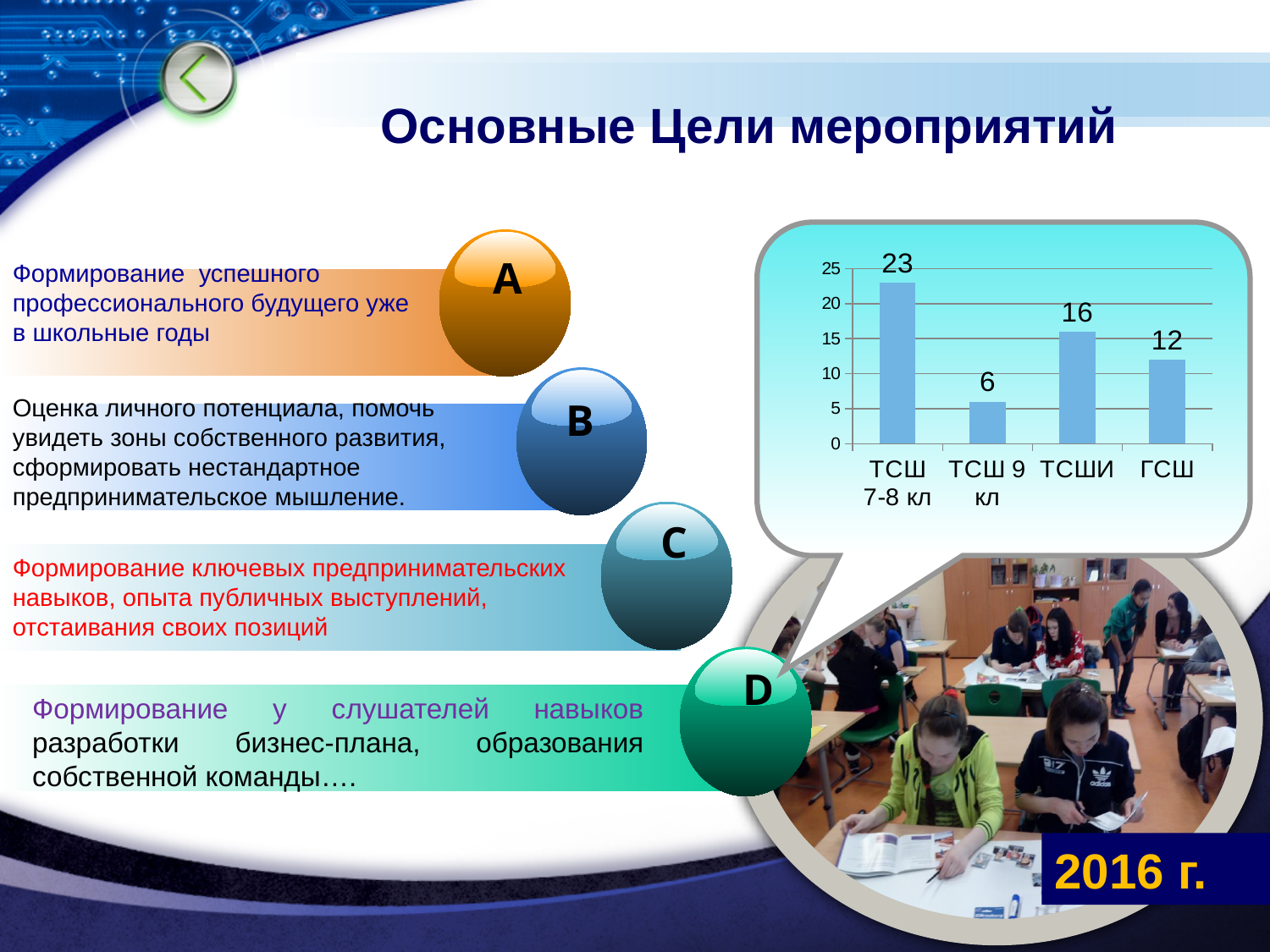
What is the difference between the values for ТСШ 7-8 кл and ТСШИ? 7 What is the value for ГСШ? 12 What kind of chart is shown on the slide? bar chart Which category has the lowest value? ТСШ 9 кл Which category has the highest value? ТСШ 7-8 кл What is the value for ТСШ 9 кл? 6 What is the value for ТСШИ? 16 What is the difference between the values for ГСШ and ТСШ 9 кл? 6 What is the value for ТСШ 7-8 кл? 23 Is the value for ТСШ 7-8 кл greater or less than 20? greater How many categories are shown on the chart? 4 Which is larger, the value for ТСШИ or the value for ГСШ? ТСШИ